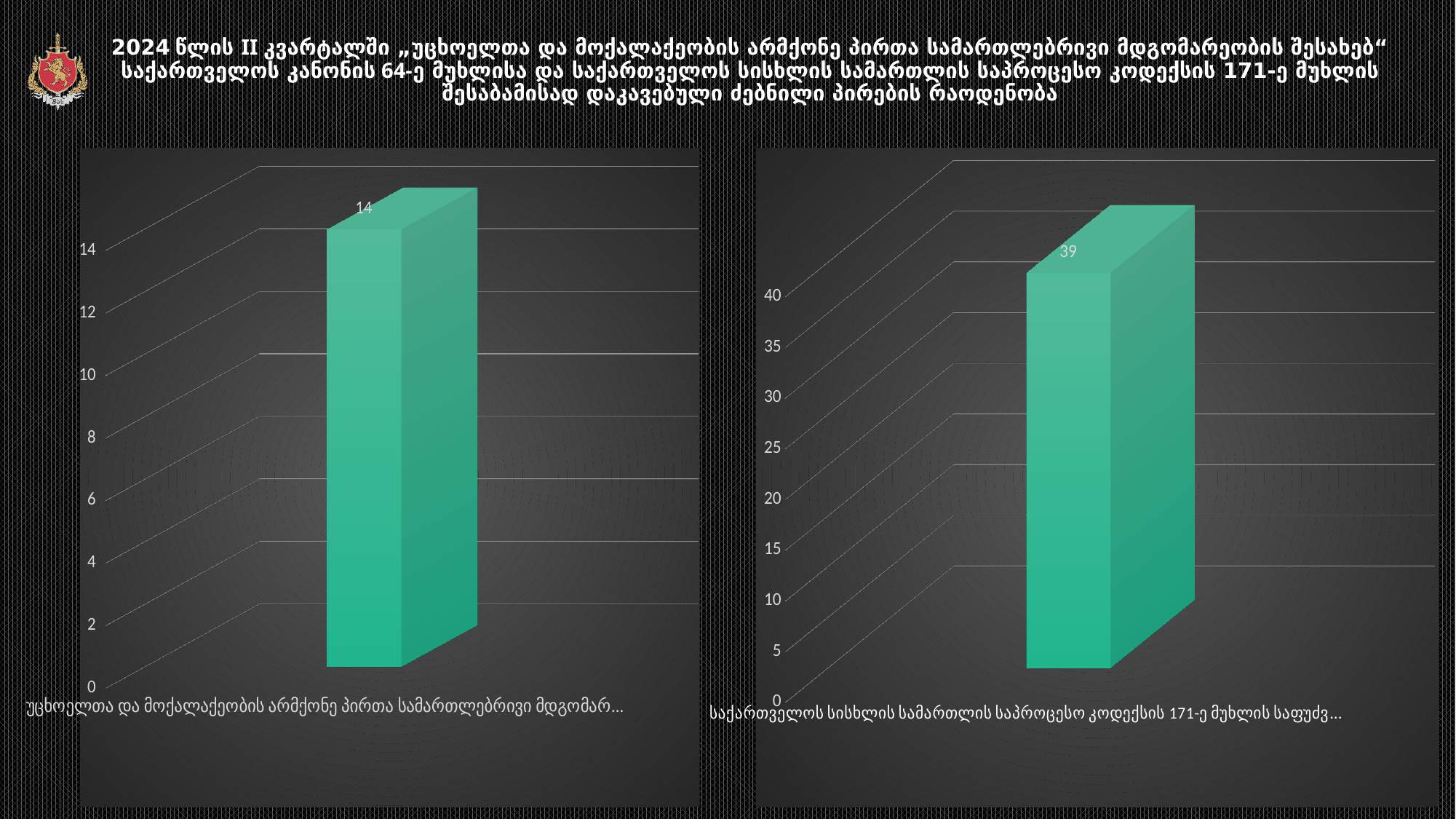
What is the difference between the value in the right chart and the value in the left chart? 25 What colour are the bars in both charts? green What kind of chart is the right chart? bar chart In the left chart, is the value of the bar greater or less than 12? greater Which chart shows the larger value, the left chart or the right chart? the right chart How many bars does the left chart contain? 1 In the left chart, what value is shown on the bar? 14 In the right chart, what value is shown on the bar? 39 What is the highest tick label on the vertical axis of the right chart? 40 How many bars does the right chart contain? 1 In the right chart, is the value of the bar greater or less than 35? greater What kind of chart is the left chart? bar chart